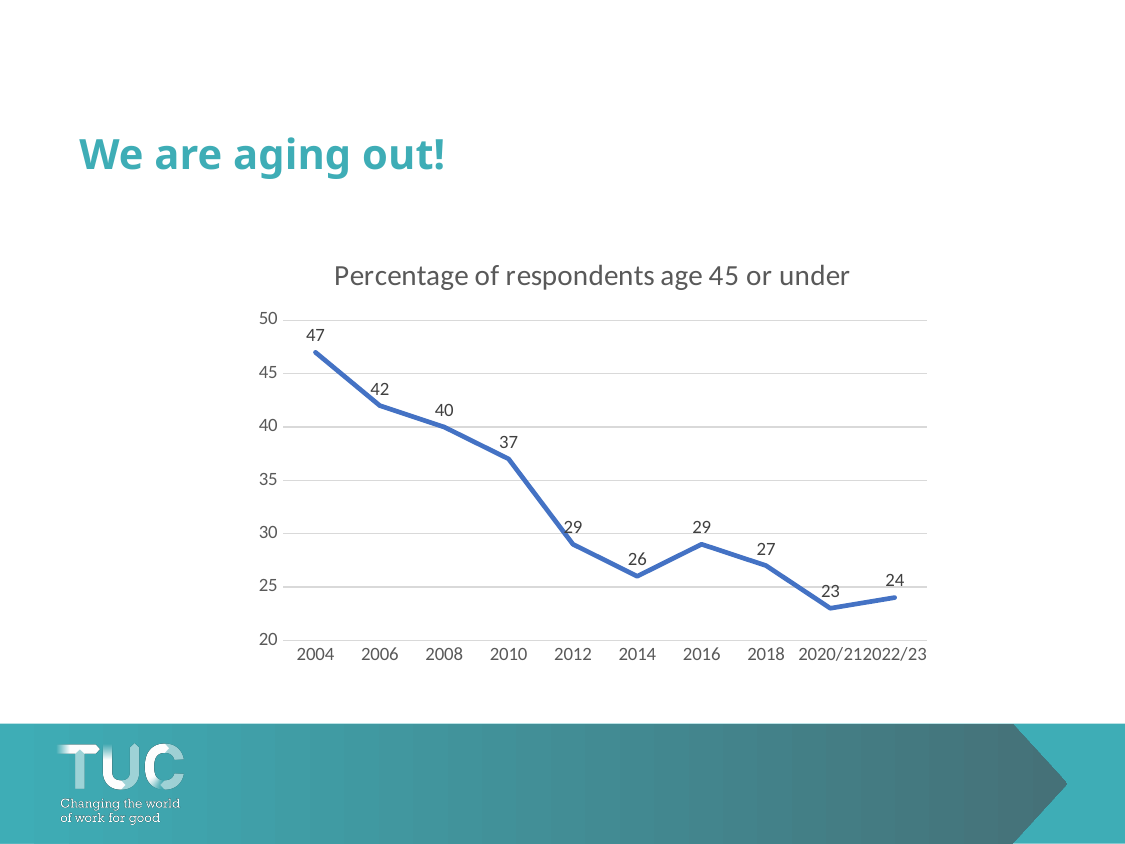
What kind of chart is shown? Line chart Which year has the highest value? 2004 What is the value for 2022/23? 24 What is the value for 2014? 26 Which year has the lowest value? 2020/21 What is the title of the chart? Percentage of respondents age 45 or under How many data points are plotted on the chart? 10 Do the values generally rise or fall from 2004 to 2022/23? Fall What is the difference between the values for 2004 and 2022/23? 23 Which is larger, the value for 2012 or the value for 2016? They are equal (29) Which is larger, the value for 2008 or the value for 2018? 2008 What is the value for 2004? 47